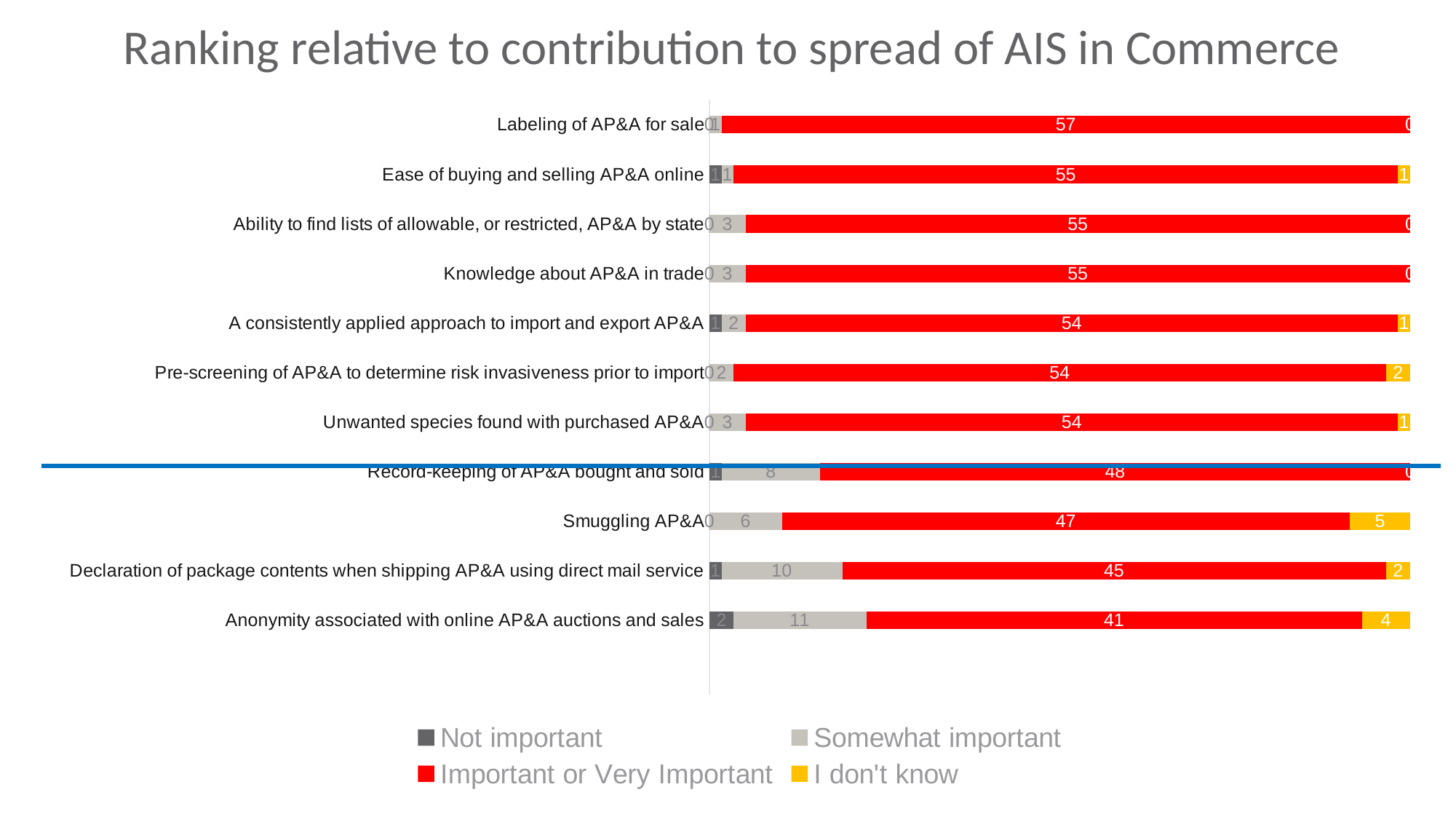
How many series does the legend list? 4 What kind of chart is shown on the slide? Stacked bar chart Which category has the lowest 'Important or Very Important' value? Anonymity associated with online AP&A auctions and sales What colour represents the 'Important or Very Important' series in the chart? Red What is the 'Important or Very Important' value for 'Labeling of AP&A for sale'? 57 What is the 'Somewhat important' value for 'Anonymity associated with online AP&A auctions and sales'? 11 What is the 'I don't know' value for 'Smuggling AP&A'? 5 What is the total of the stacked bar for 'Anonymity associated with online AP&A auctions and sales'? 58 Which category has the highest 'Important or Very Important' value? Labeling of AP&A for sale How many categories are plotted in the chart? 11 Which has the larger 'Somewhat important' value: 'Declaration of package contents when shipping AP&A using direct mail service' or 'Smuggling AP&A'? Declaration of package contents when shipping AP&A using direct mail service What is the difference between the 'Important or Very Important' values for 'Labeling of AP&A for sale' and 'Anonymity associated with online AP&A auctions and sales'? 16